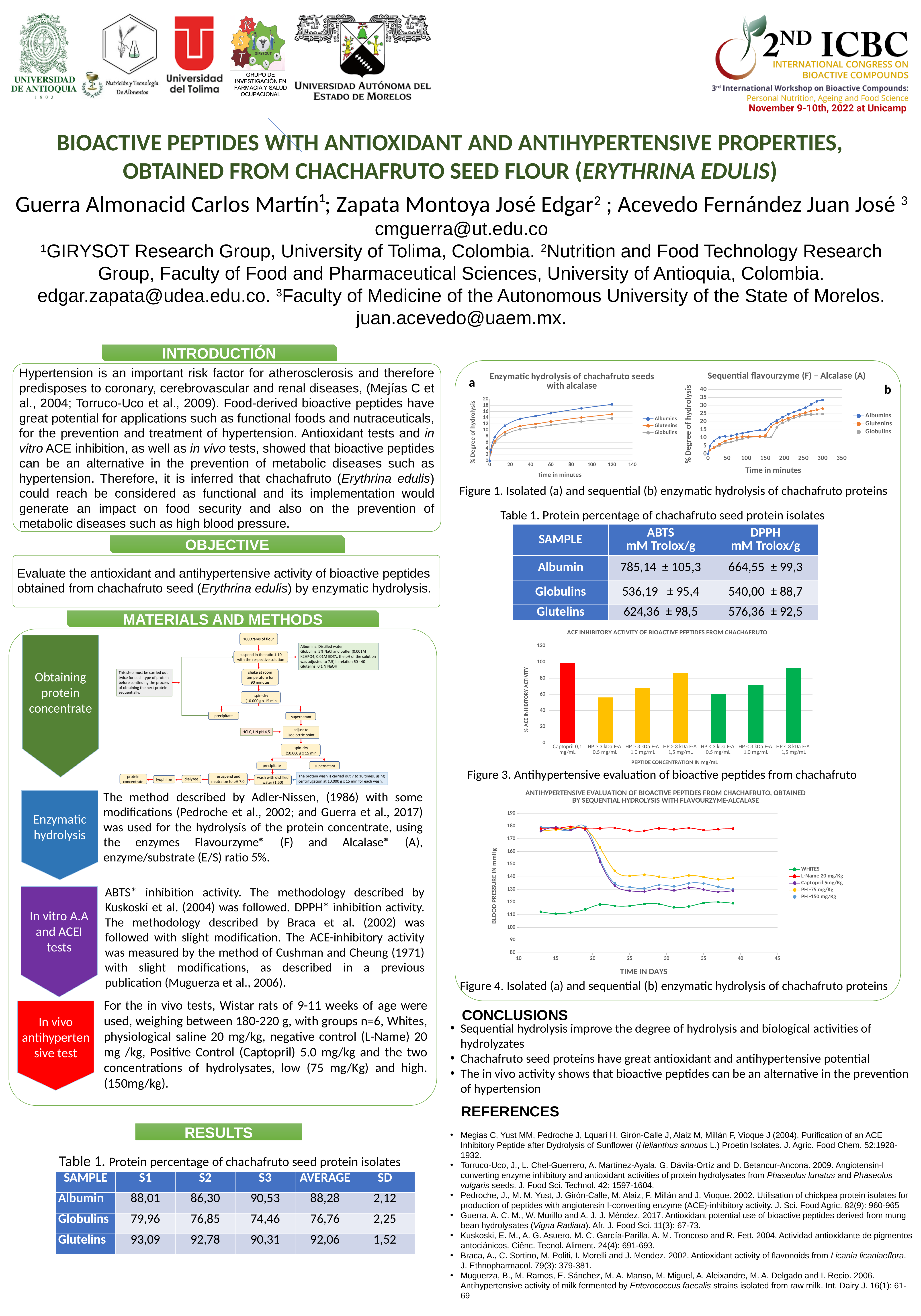
In the 'Sequential flavourzyme (F) – Alcalase (A)' chart, is the % degree of hydrolysis for Albumins at 300 minutes greater or less than 30? greater How many series does the legend list in the 'ANTIHYPERTENSIVE EVALUATION OF BIOACTIVE PEPTIDES FROM CHACHAFRUTO' chart? 5 In the 'ACE INHIBITORY ACTIVITY OF BIOACTIVE PEPTIDES FROM CHACHAFRUTO' chart, how many bars are plotted? 7 How many series does the legend list in the 'Enzymatic hydrolysis of chachafruto seeds with alcalase' chart? 3 In the 'Enzymatic hydrolysis of chachafruto seeds with alcalase' chart, does the % degree of hydrolysis for Albumins rise or fall as time in minutes increases? rise In the 'ACE INHIBITORY ACTIVITY OF BIOACTIVE PEPTIDES FROM CHACHAFRUTO' chart, which peptide concentration has the highest % ACE inhibitory activity? Captopril 0,1 mg/mL What kind of chart is the 'ACE INHIBITORY ACTIVITY OF BIOACTIVE PEPTIDES FROM CHACHAFRUTO' chart? bar chart In the 'ANTIHYPERTENSIVE EVALUATION OF BIOACTIVE PEPTIDES FROM CHACHAFRUTO' chart, which series has the highest blood pressure at the end of the time period? L-Name 20 mg/Kg In the 'Sequential flavourzyme (F) – Alcalase (A)' chart, which series reaches the highest % degree of hydrolysis at 300 minutes? Albumins In the 'ACE INHIBITORY ACTIVITY OF BIOACTIVE PEPTIDES FROM CHACHAFRUTO' chart, is the value for Captopril 0,1 mg/mL greater or less than 80? greater In the 'ACE INHIBITORY ACTIVITY OF BIOACTIVE PEPTIDES FROM CHACHAFRUTO' chart, which is larger: HP > 3 kDa F-A 1,5 mg/mL or HP > 3 kDa F-A 0,5 mg/mL? HP > 3 kDa F-A 1,5 mg/mL In the 'ACE INHIBITORY ACTIVITY OF BIOACTIVE PEPTIDES FROM CHACHAFRUTO' chart, which peptide concentration has the lowest % ACE inhibitory activity? HP > 3 kDa F-A 0,5 mg/mL